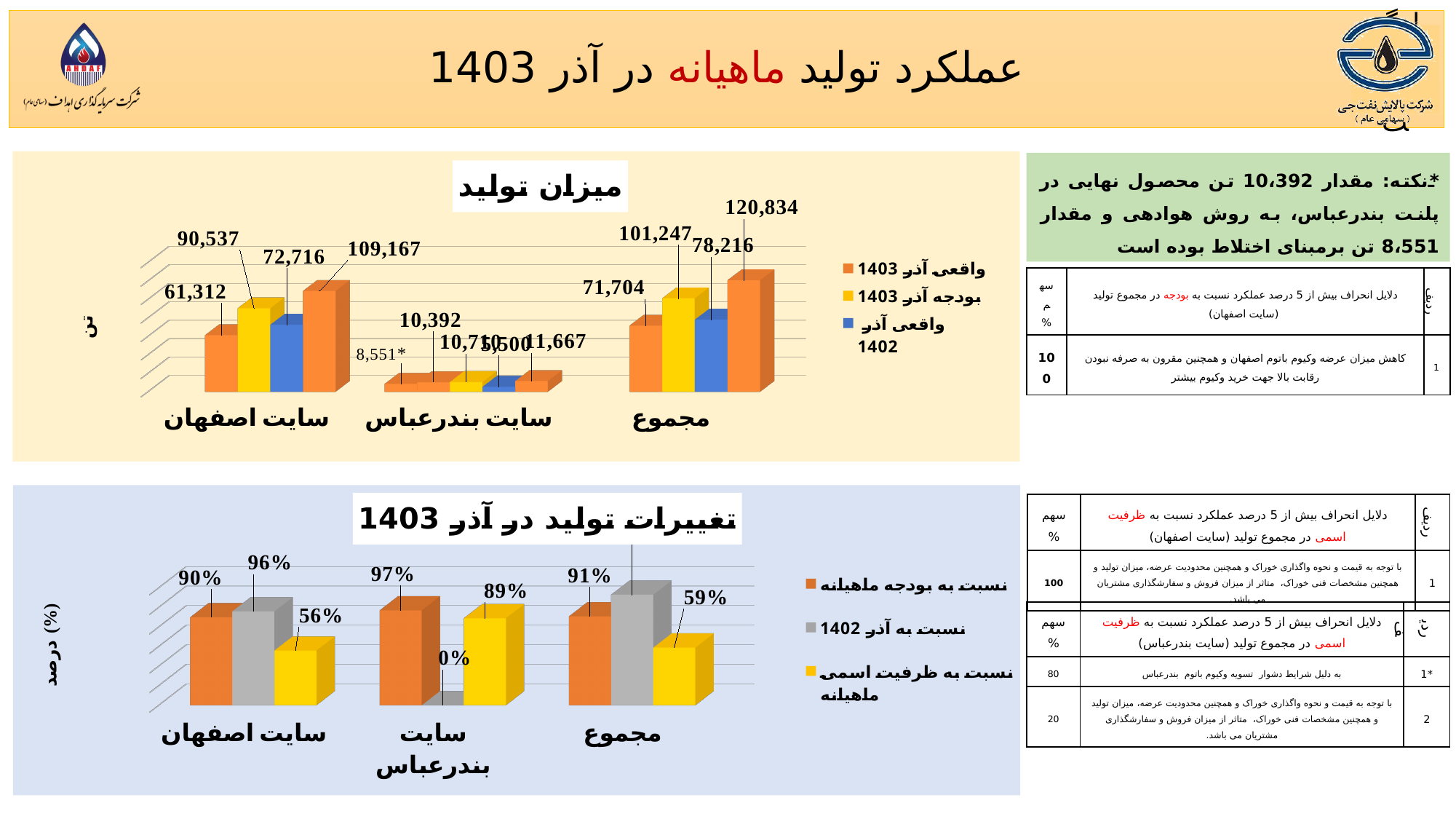
In the top chart (میزان تولید), what is the value of واقعی آذر 1403 for مجموع? 71,704 In the top chart (میزان تولید), what is the value of واقعی آذر 1403 for سایت اصفهان? 61,312 In the bottom chart (تغییرات تولید در آذر 1403), for سایت اصفهان, which is larger: نسبت به آذر 1402 or نسبت به ظرفیت اسمی ماهیانه? نسبت به آذر 1402 In the top chart (میزان تولید), what is the difference between بودجه آذر 1403 and واقعی آذر 1403 for سایت اصفهان? 29,225 In the top chart (میزان تولید), what is the value of بودجه آذر 1403 for سایت اصفهان? 90,537 What kind of chart is the top chart (میزان تولید)? Bar chart In the bottom chart (تغییرات تولید در آذر 1403), what is the value of نسبت به ظرفیت اسمی ماهیانه for سایت اصفهان? 56% How many series does the legend of the bottom chart (تغییرات تولید در آذر 1403) list? 3 In the top chart (میزان تولید), what is the value of واقعی آذر 1402 for مجموع? 78,216 In the top chart (میزان تولید), which category has the highest value for واقعی آذر 1403? مجموع How many categories are shown on the x axis of the top chart (میزان تولید)? 3 In the bottom chart (تغییرات تولید در آذر 1403), what is the value of نسبت به بودجه ماهیانه for سایت بندرعباس? 97%